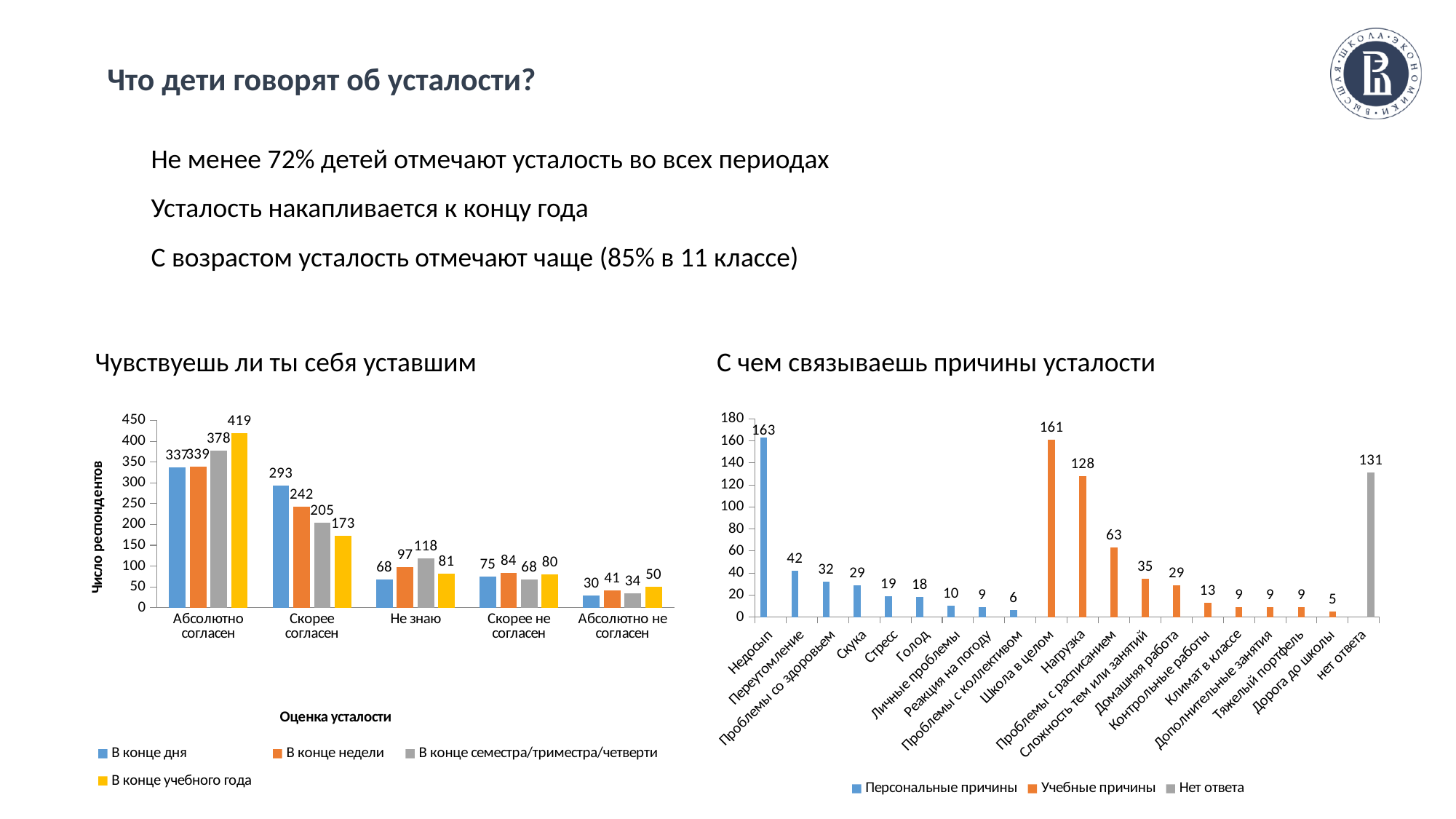
In the chart 'Чувствуешь ли ты себя уставшим', what is the value for 'В конце дня' in the 'Скорее согласен' category? 293 What type of chart is 'С чем связываешь причины усталости'? Bar chart In the chart 'С чем связываешь причины усталости', what is the difference between 'Недосып' and 'Школа в целом'? 2 In the chart 'Чувствуешь ли ты себя уставшим', how many series does the legend list? 4 In the chart 'Чувствуешь ли ты себя уставшим', what is the value for 'В конце учебного года' in the 'Абсолютно согласен' category? 419 In the chart 'Чувствуешь ли ты себя уставшим', how many categories are shown on the x axis? 5 In the chart 'С чем связываешь причины усталости', what is the value for 'Недосып'? 163 In the chart 'С чем связываешь причины усталости', which category has the highest value? Недосып In the chart 'С чем связываешь причины усталости', what is the value for 'Нагрузка'? 128 In the chart 'С чем связываешь причины усталости', which is larger: 'Школа в целом' or 'Проблемы с расписанием'? Школа в целом In the chart 'Чувствуешь ли ты себя уставшим', which category has the lowest value for 'В конце недели'? Абсолютно не согласен In the chart 'Чувствуешь ли ты себя уставшим', what is the difference between 'В конце учебного года' and 'В конце дня' in the 'Абсолютно согласен' category? 82